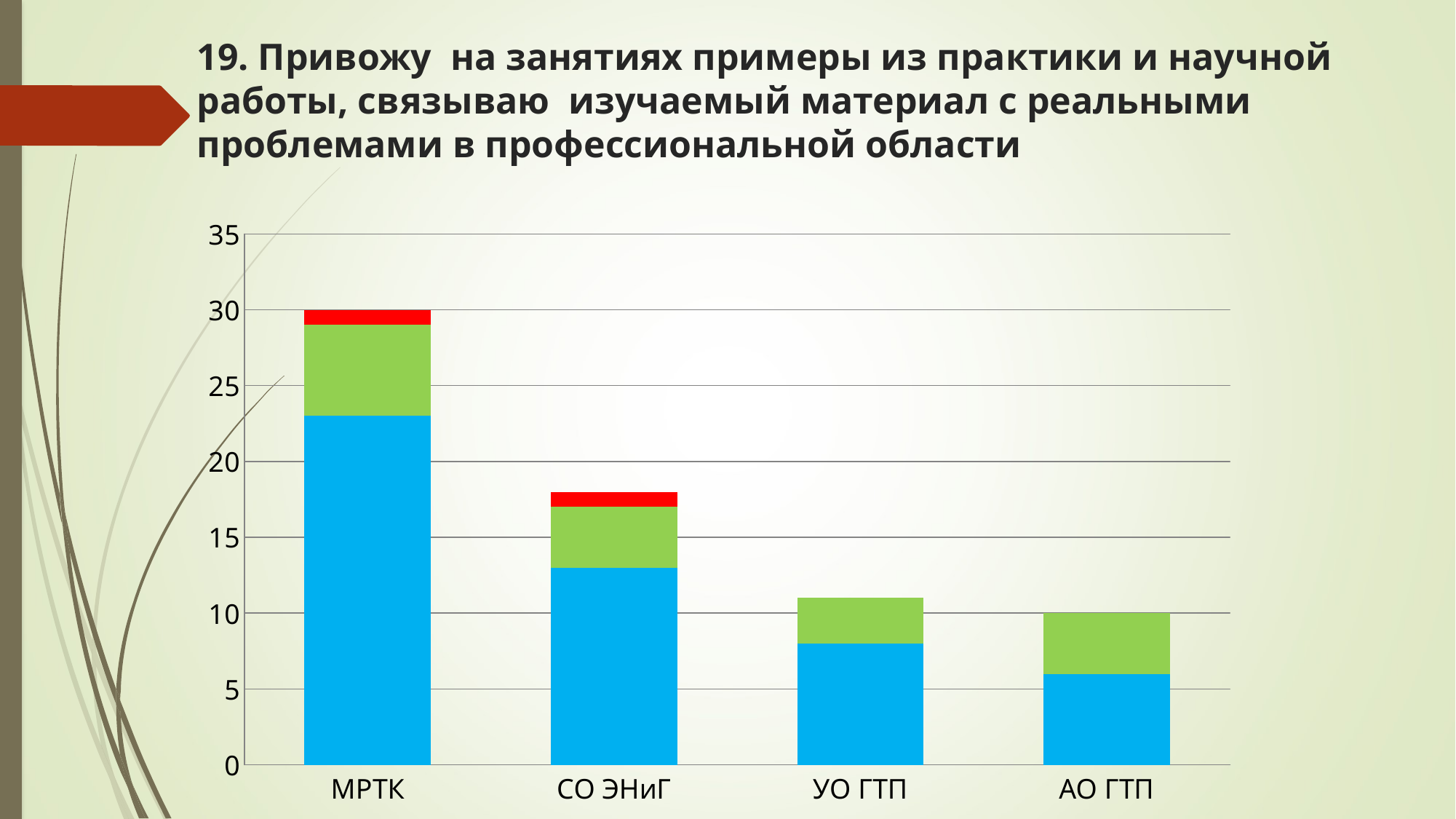
Do the bar totals rise or fall from left to right along the x axis? fall Which category has the tallest stacked bar? МРТК What is the difference between the total for МРТК and the total for АО ГТП? 20 What kind of chart is shown on the slide? stacked bar chart Which has a larger total, СО ЭНиГ or УО ГТП? СО ЭНиГ How many categories are shown on the x axis of the chart? 4 What is the total height of the stacked bar for МРТК? 30 Is the total value for СО ЭНиГ greater or less than 15? greater Which category has the shortest stacked bar? АО ГТП Is the total value for УО ГТП greater or less than 15? less What colour is the bottom segment of each stacked bar? blue What is the total height of the stacked bar for АО ГТП? 10